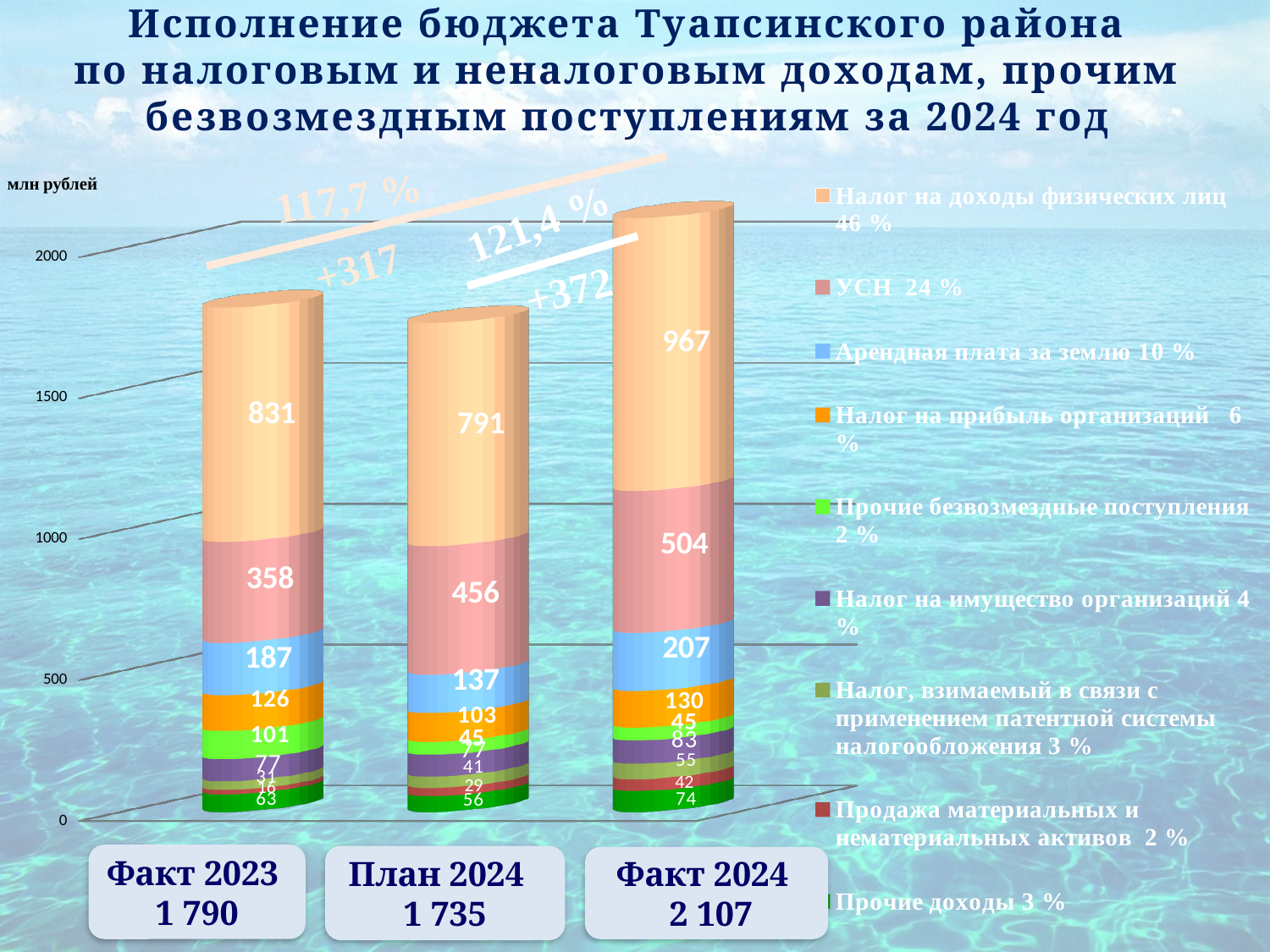
What is the value of Налог на прибыль организаций for Факт 2024? 130 Which is larger: УСН for Факт 2023 or УСН for План 2024? План 2024 What is the value of Арендная плата за землю for Факт 2023? 187 Which bar has the highest total? Факт 2024 Which bar has the lowest total? План 2024 What is the value of Налог на доходы физических лиц for Факт 2024? 967 What kind of chart is shown on the slide? Stacked bar chart What is the value of УСН for План 2024? 456 How many series does the legend list? 9 What percentage does the legend give for Налог на доходы физических лиц? 46 % What is the difference between the total for Факт 2024 and the total for Факт 2023? 317 How many bars are shown in the chart? 3